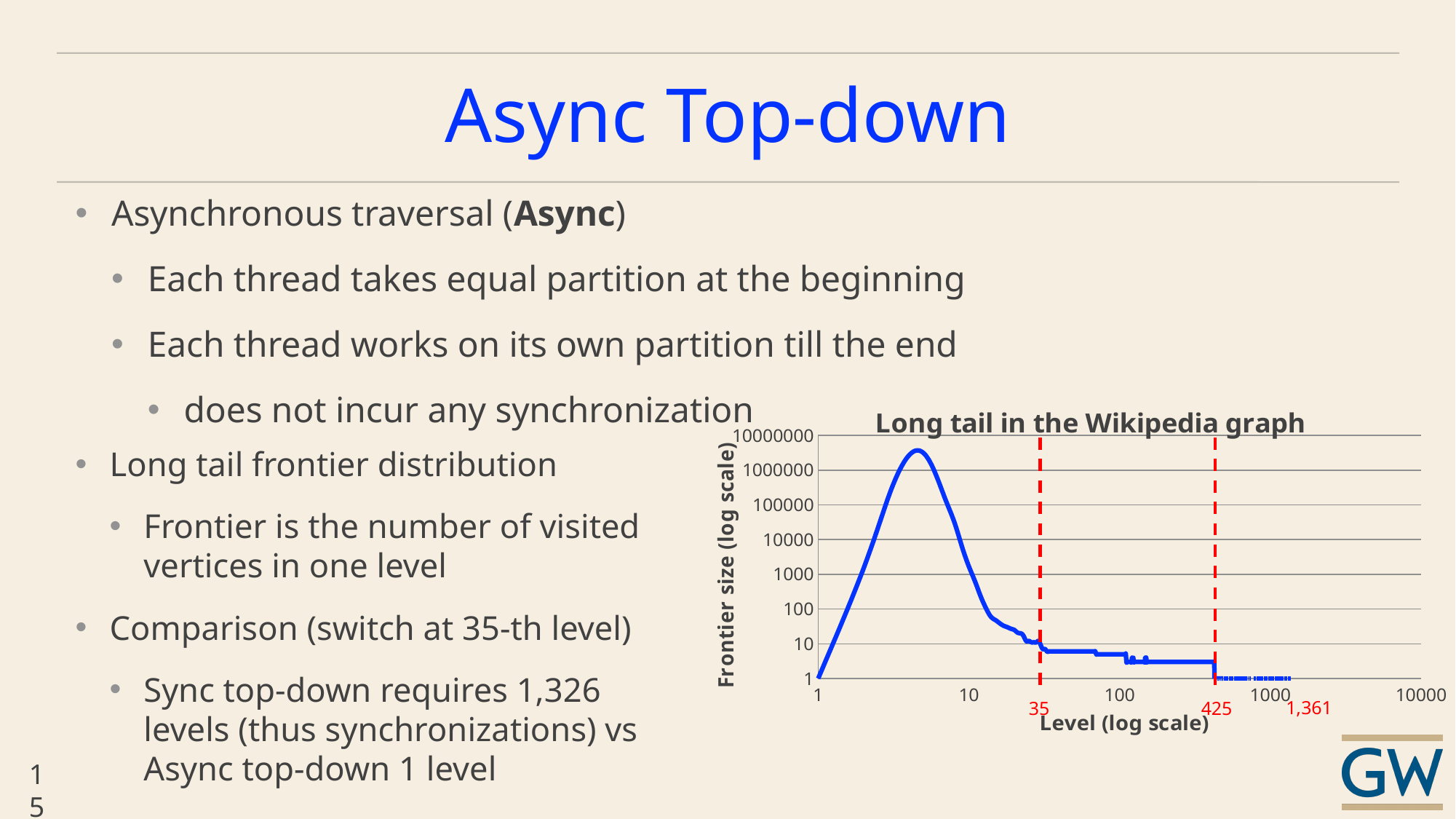
Is the frontier size at level 1000 greater or less than 10? less Is the frontier size at level 100 greater or less than 10? less Is the frontier size at level 10 greater or less than 1000? greater After the peak, does the frontier size rise or fall as the level increases? fall How many data series are plotted in the chart? 1 What is the largest tick value shown on the x axis of the chart? 10000 What is the title of the chart? Long tail in the Wikipedia graph What is the largest tick value shown on the y axis of the chart? 10000000 What kind of chart is shown on the slide? line chart At which two levels are the red dashed vertical lines drawn on the chart? 35 and 425